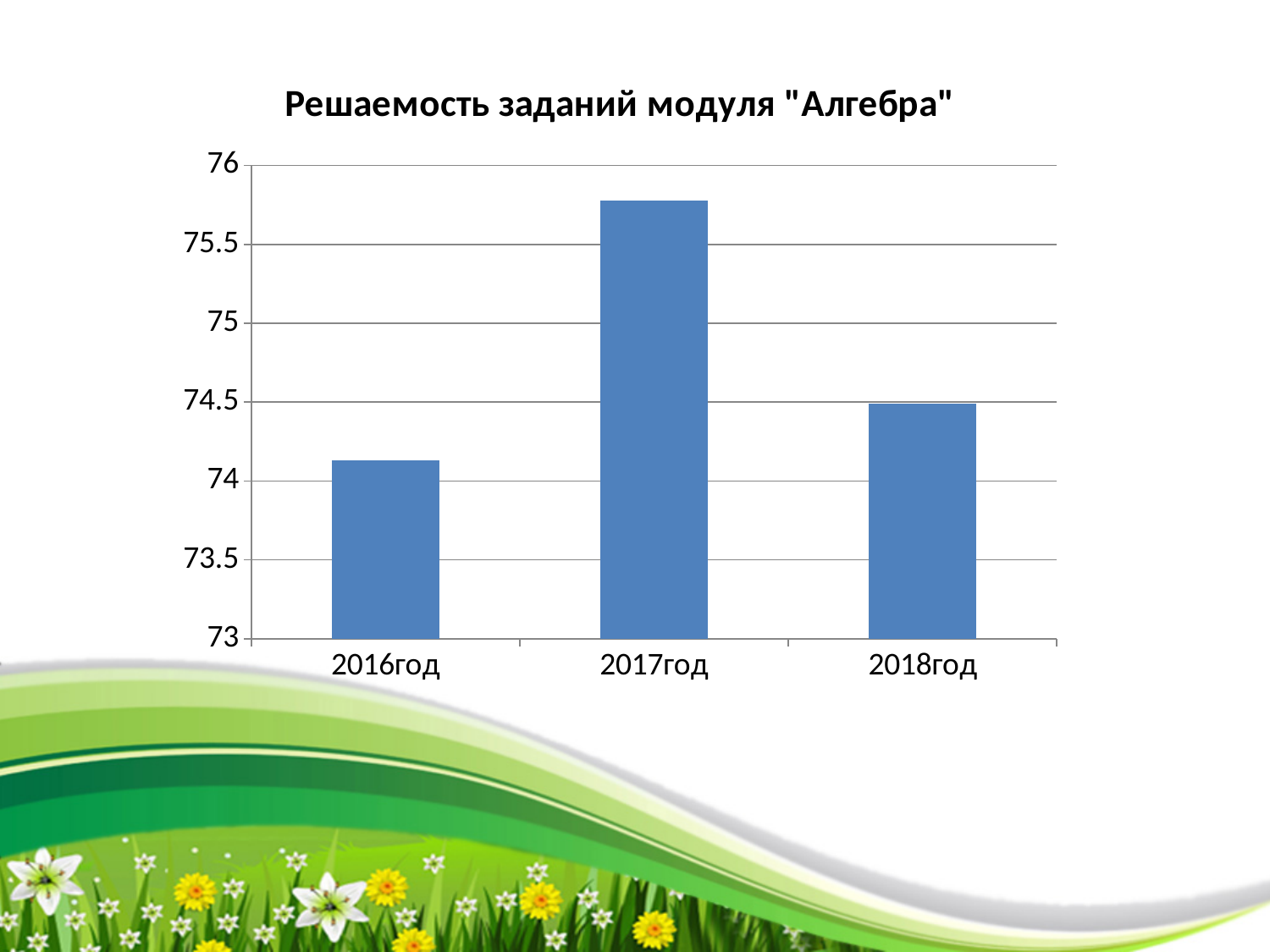
Is the value for 2018год greater or less than 74? greater Which is larger, the value for 2017год or the value for 2018год? 2017год Which year has the lowest value? 2016год Is the value for 2016год greater or less than 74? greater How many categories (years) are shown on the x axis? 3 Which is larger, the value for 2016год or the value for 2018год? 2018год What is the title of the chart? Решаемость заданий модуля "Алгебра" Which year has the highest value? 2017год Do the values rise or fall from 2017год to 2018год? fall What kind of chart is shown on the slide? bar chart Is the value for 2016год greater or less than 74.5? less